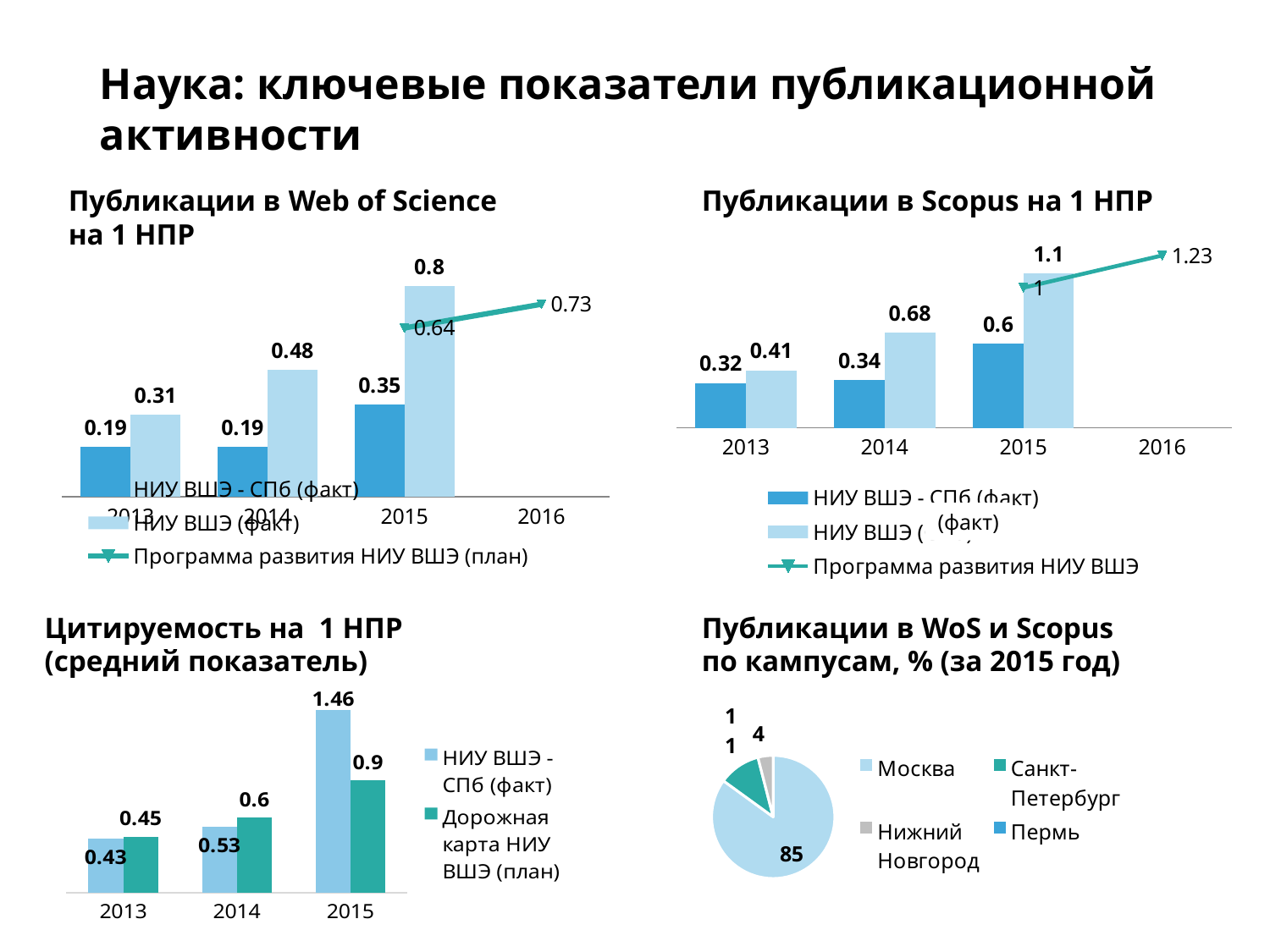
In the chart 'Публикации в Web of Science на 1 НПР', what is the planned value (Программа развития НИУ ВШЭ) for 2016? 0.73 In the chart 'Публикации в Scopus на 1 НПР', in which year is the НИУ ВШЭ (факт) value highest? 2015 In the pie chart 'Публикации в WoS и Scopus по кампусам, % (за 2015 год)', what share does Москва have? 85 In the chart 'Цитируемость на 1 НПР (средний показатель)', what is the value for НИУ ВШЭ - СПб (факт) in 2015? 1.46 In the chart 'Цитируемость на 1 НПР (средний показатель)', what is the difference between the 2015 fact value and the 2015 plan value? 0.56 In the chart 'Публикации в Scopus на 1 НПР', do the НИУ ВШЭ - СПб (факт) values rise or fall from 2013 to 2015? rise In the chart 'Публикации в Web of Science на 1 НПР', what is the value for НИУ ВШЭ (факт) in 2015? 0.8 What kind of chart is 'Публикации в WoS и Scopus по кампусам, % (за 2015 год)'? pie chart In the chart 'Публикации в Scopus на 1 НПР', what is the value for НИУ ВШЭ - СПб (факт) in 2014? 0.34 In the chart 'Публикации в Scopus на 1 НПР', what is the planned value for 2016? 1.23 In the chart 'Цитируемость на 1 НПР (средний показатель)', which is larger in 2014: НИУ ВШЭ - СПб (факт) or Дорожная карта НИУ ВШЭ (план)? Дорожная карта НИУ ВШЭ (план) In the chart 'Публикации в Web of Science на 1 НПР', what is the difference between НИУ ВШЭ (факт) and НИУ ВШЭ - СПб (факт) in 2015? 0.45